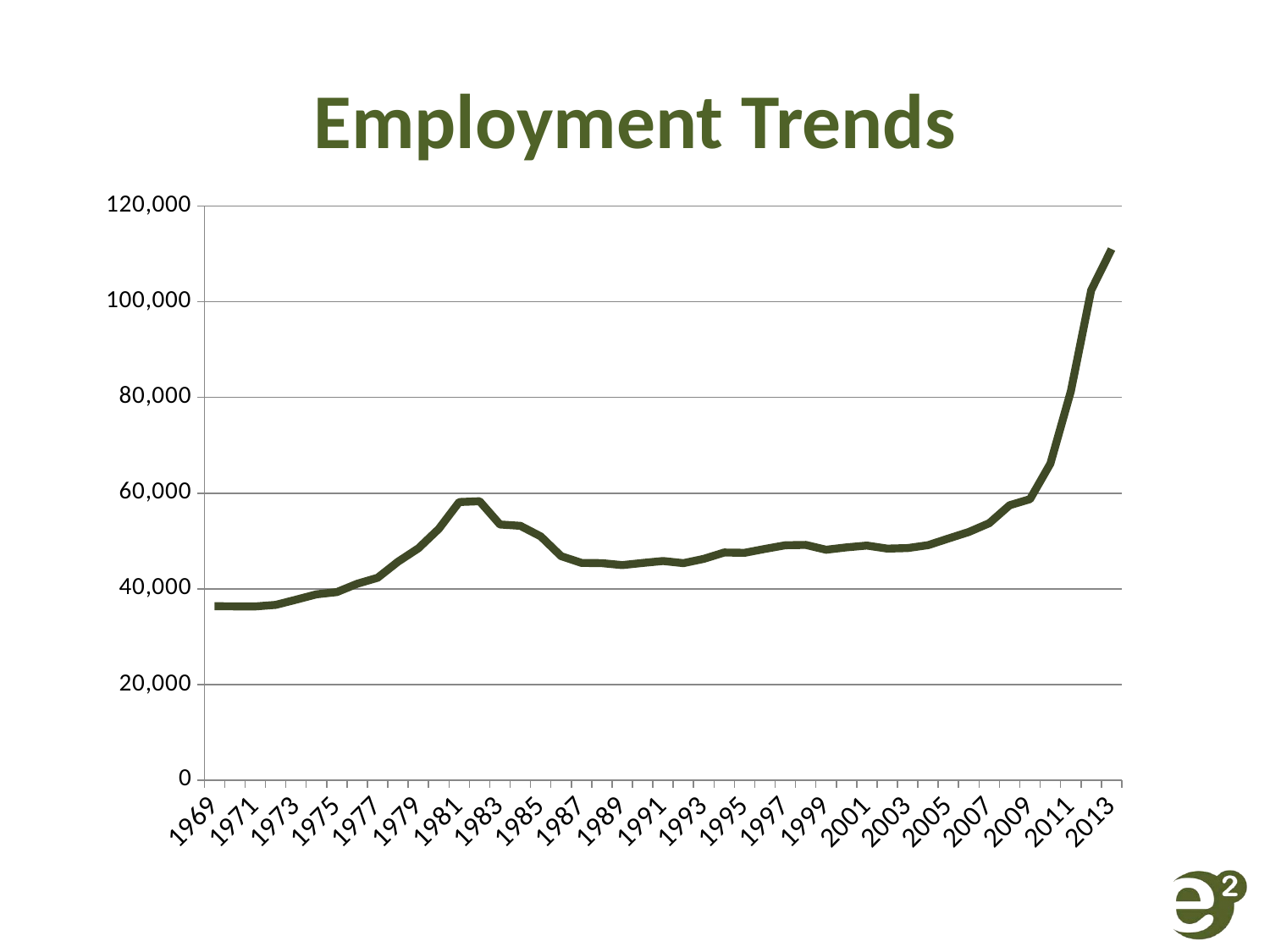
Is the value for 1999 greater or less than 60,000? less Which year has the highest value on the chart? 2013 Is the value for 2013 greater or less than 100,000? greater Which is larger, the value for 2009 or the value for 1999? 2009 Is the value for 1985 greater or less than 60,000? less Do the values rise or fall from 1983 to 1987? fall Do the values rise or fall from 2009 to 2013? rise What kind of chart is shown on the slide? Line chart What is the title of the chart? Employment Trends Which is larger, the value for 1982 or the value for 1969? 1982